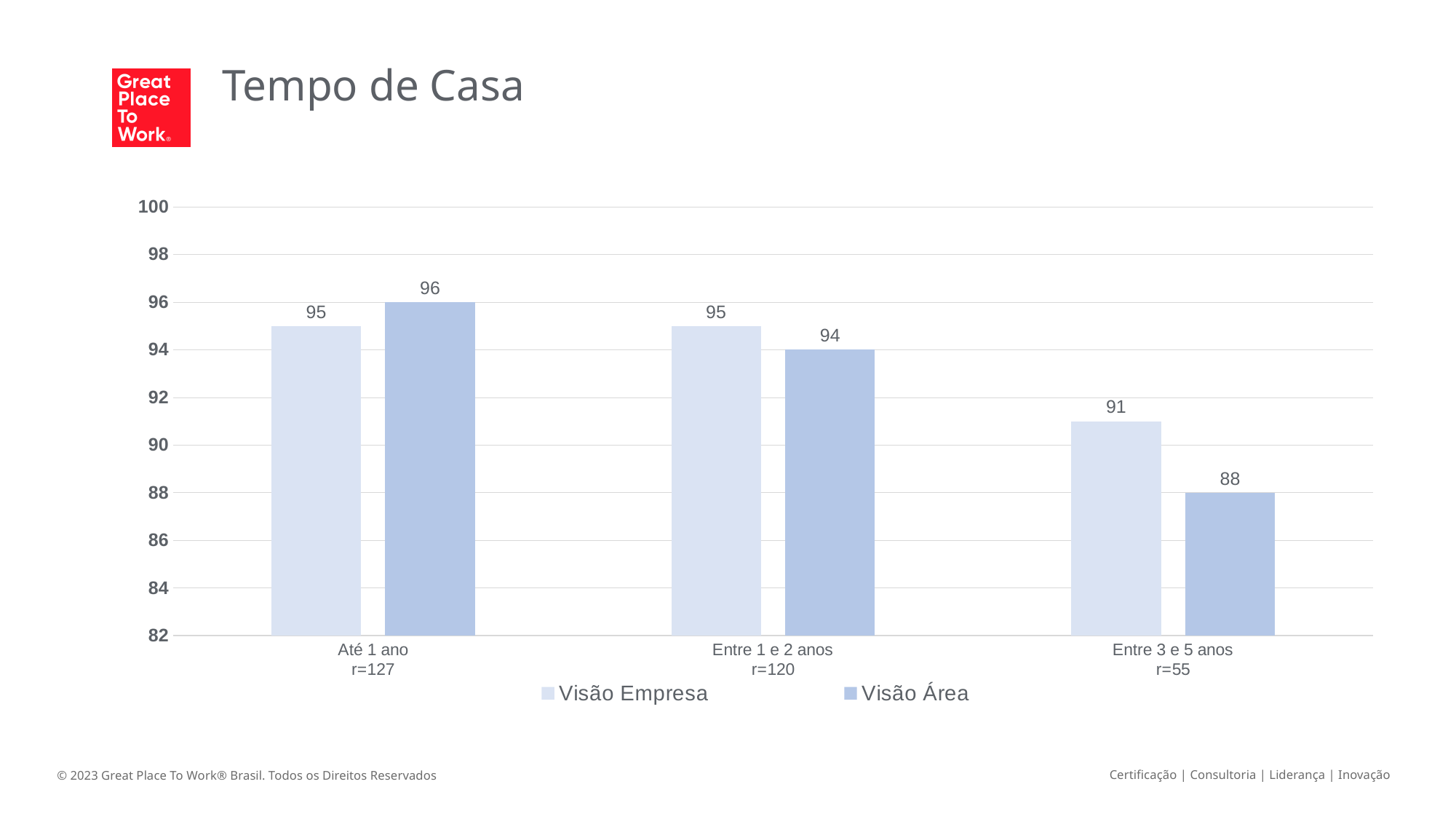
What is the difference between Visão Empresa and Visão Área for 'Entre 3 e 5 anos'? 3 For 'Entre 1 e 2 anos', which is larger: Visão Empresa or Visão Área? Visão Empresa What is the Visão Área value for 'Até 1 ano'? 96 What is the Visão Empresa value for 'Entre 3 e 5 anos'? 91 What is the Visão Área value for 'Entre 1 e 2 anos'? 94 How many categories are shown on the x axis? 3 Do the Visão Área values rise or fall from 'Até 1 ano' to 'Entre 3 e 5 anos'? Fall How many series does the legend list? 2 Which category has the lowest Visão Área value? Entre 3 e 5 anos What is the title of the chart? Tempo de Casa What kind of chart is shown on the slide? Bar chart Which category has the highest Visão Área value? Até 1 ano